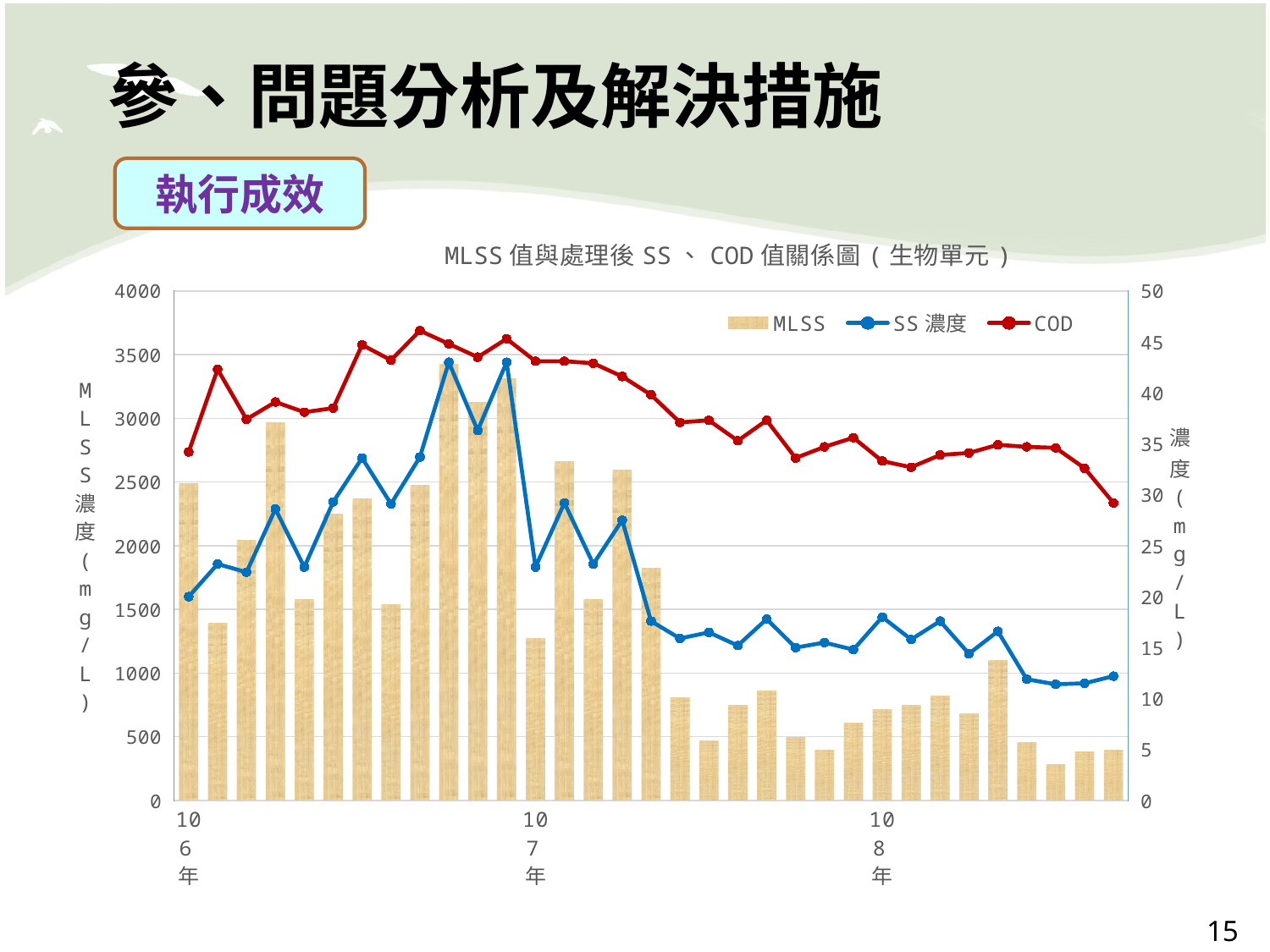
Which series is drawn as bars in the chart? MLSS Is the tallest MLSS bar greater or less than 3000? greater Is the highest COD value greater or less than 40 on the right axis? greater Is the last COD value on the right of the chart greater or less than 25 on the right axis? greater How many series does the chart legend list? 3 How many year labels (年) appear on the x axis? 3 What is the title of the chart? MLSS 值與處理後 SS 、 COD 值關係圖（生物單元） Overall, does the COD line rise or fall from 106年 to the end of 108年? fall What kind of chart is shown on the slide? A combined bar and line chart At the first data point in 106年, which line is higher on the right axis, COD or SS 濃度? COD